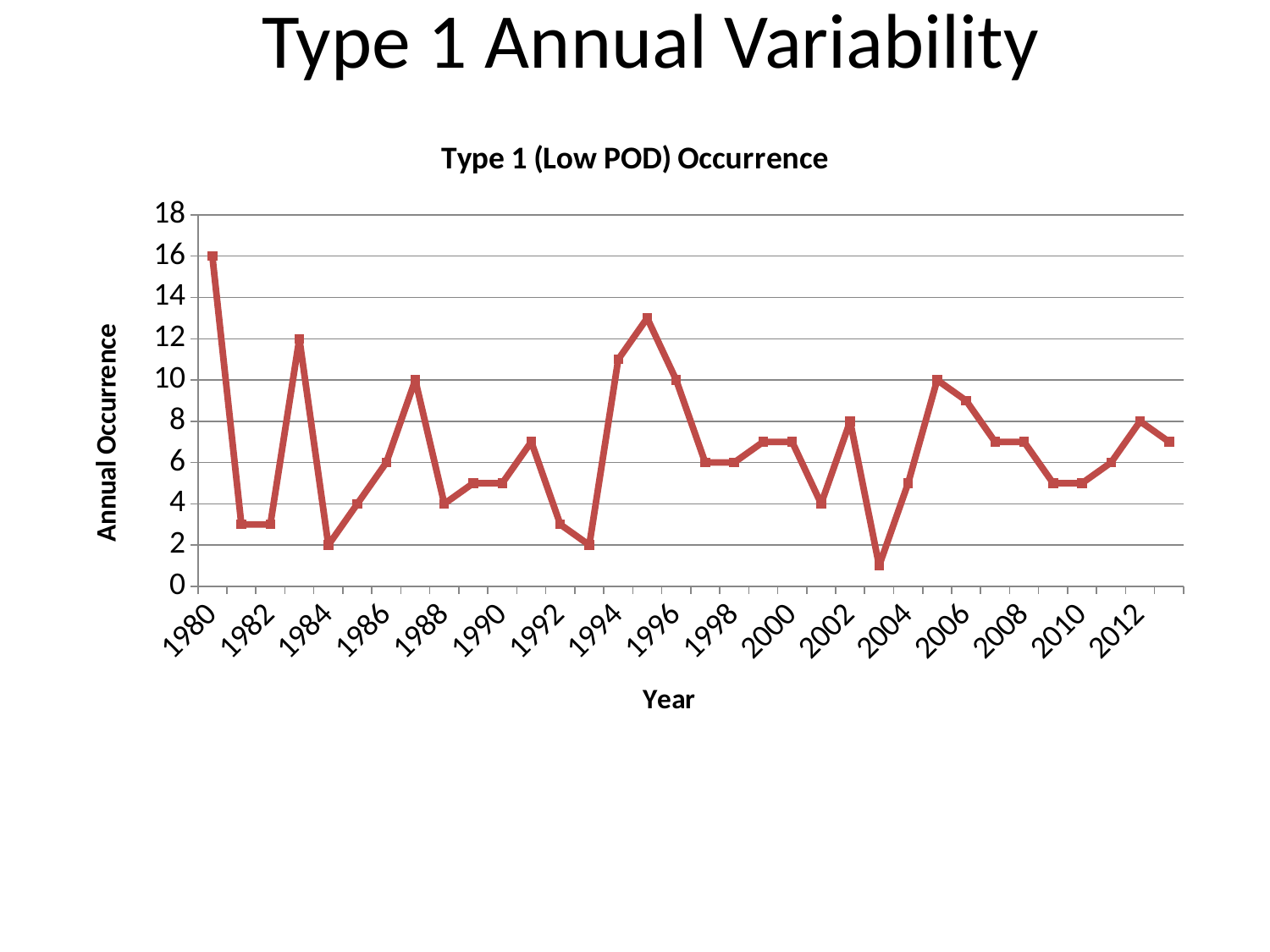
What is the annual occurrence in 1980? 16 What is the annual occurrence in 1996? 10 Which year has the highest annual occurrence? 1980 What is the difference in annual occurrence between 1980 and 1983? 4 What is the annual occurrence in 1984? 2 What is the label of the vertical axis? Annual Occurrence Is the annual occurrence in 2003 greater or less than 2? less What kind of chart is shown on the slide? line chart Is the annual occurrence in 1994 greater or less than 10? greater What is the title of the chart? Type 1 (Low POD) Occurrence Does the annual occurrence rise or fall from 1980 to 1981? fall Which year has a higher annual occurrence, 1983 or 1987? 1983